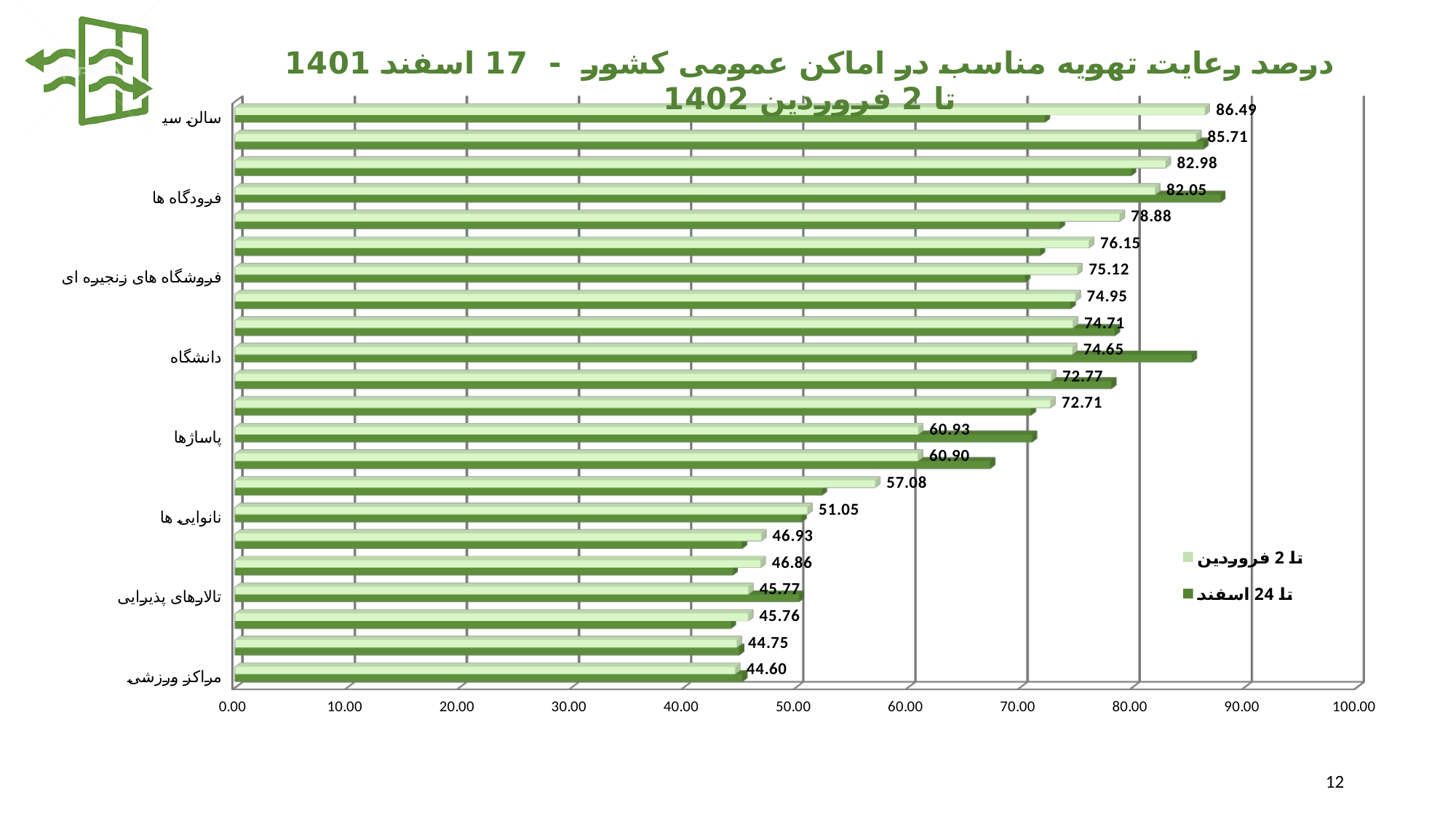
Is the 'تا 24 اسفند' value for 'مراکز ورزشی' greater or less than 50.00? less What is the value of the 'تا 2 فروردین' series for 'دانشگاه'? 74.65 Is the 'تا 24 اسفند' value for 'فرودگاه ها' greater or less than 80.00? greater Which has a larger 'تا 2 فروردین' value, 'پاساژها' or 'نانوایی ها'? پاساژها How many series does the legend list? 2 Which labeled category has the lowest 'تا 2 فروردین' value? مراکز ورزشی What is the value of the 'تا 2 فروردین' series for 'فرودگاه ها'? 82.05 What is the difference between the 'تا 2 فروردین' values for 'فرودگاه ها' and 'دانشگاه'? 7.40 What is the highest value shown for the 'تا 2 فروردین' series? 86.49 What is the value of the 'تا 2 فروردین' series for 'نانوایی ها'? 51.05 What is the value of the 'تا 2 فروردین' series for 'مراکز ورزشی'? 44.60 What kind of chart is shown on the slide? Bar chart